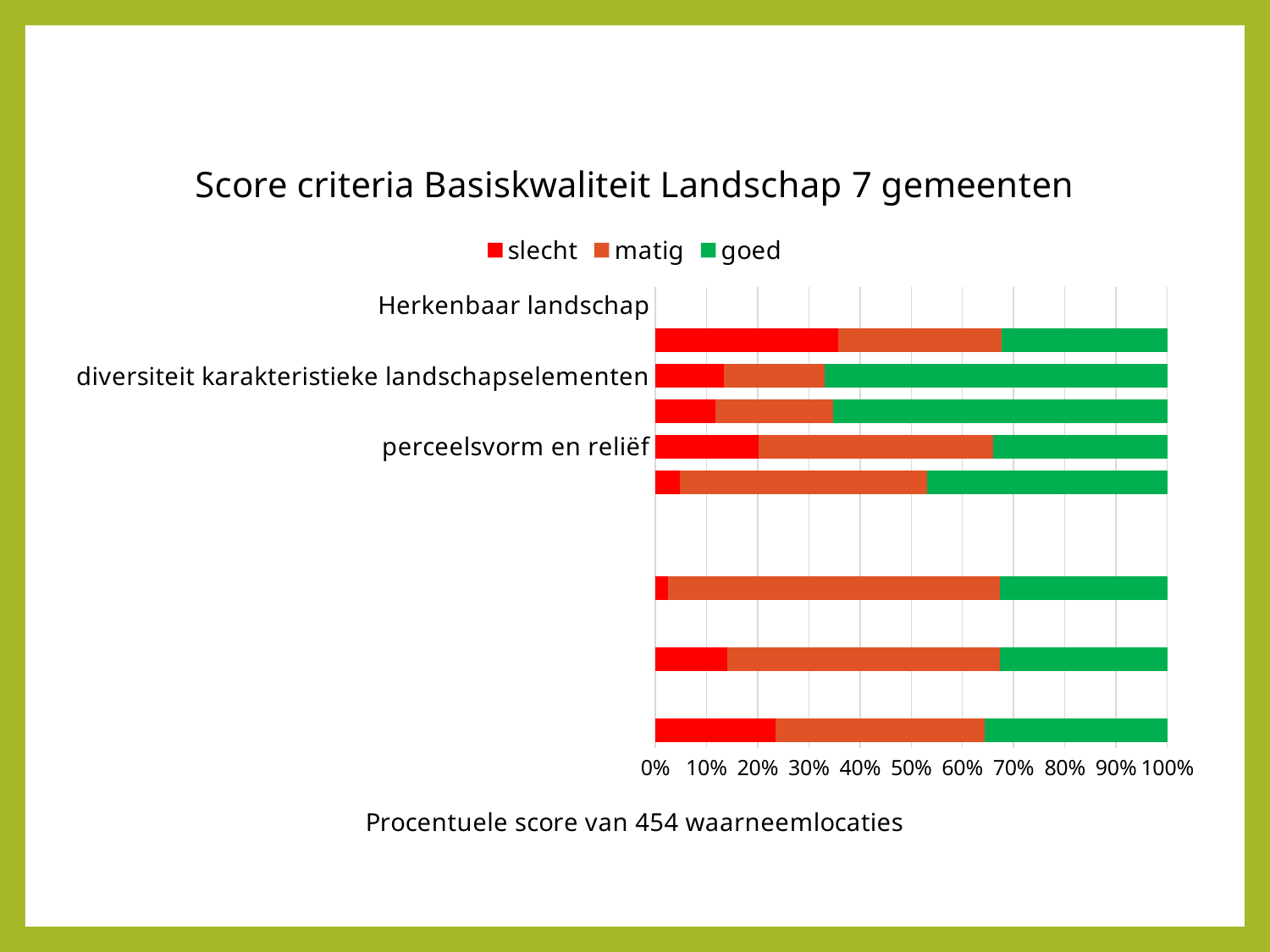
Is the 'slecht' share of the bottommost bar greater or less than 30%? less Is the 'slecht' share of the bar labelled 'diversiteit karakteristieke landschapselementen' greater or less than 20%? less How many bars are plotted in the chart? 8 What kind of chart is shown on the slide? stacked bar chart What is the title of the chart? Score criteria Basiskwaliteit Landschap 7 gemeenten How many series does the legend list? 3 In the topmost bar, which segment is larger: 'slecht' or 'goed'? slecht Which series is shown in green in the legend? goed In the bar labelled 'diversiteit karakteristieke landschapselementen', which segment is larger: 'matig' or 'goed'? goed Is the 'slecht' share of the topmost bar greater or less than 30%? greater What is the maximum value shown on the horizontal axis? 100%